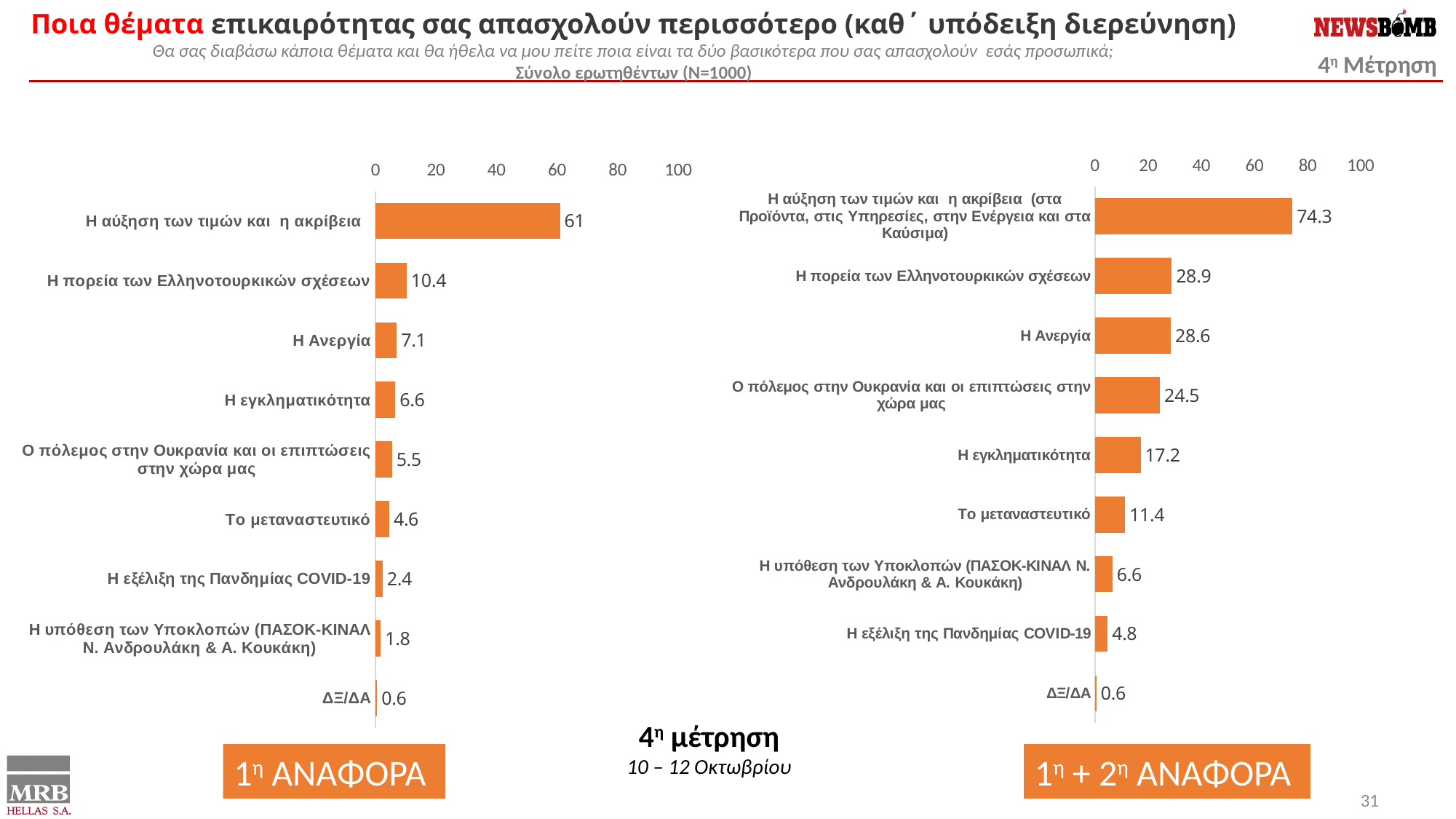
In the right chart (1η + 2η ΑΝΑΦΟΡΑ), what is the difference between 'Ο πόλεμος στην Ουκρανία και οι επιπτώσεις στην χώρα μας' and 'Η εγκληματικότητα'? 7.3 In the left chart (1η ΑΝΑΦΟΡΑ), which is larger: 'Η Ανεργία' or 'Η εγκληματικότητα'? Η Ανεργία What kind of chart is the right chart (1η + 2η ΑΝΑΦΟΡΑ)? Bar chart In the left chart (1η ΑΝΑΦΟΡΑ), what is the value for 'Η αύξηση των τιμών και η ακρίβεια'? 61 In the right chart (1η + 2η ΑΝΑΦΟΡΑ), is the value for 'Η Ανεργία' greater or less than 20? greater In the left chart (1η ΑΝΑΦΟΡΑ), which category has the lowest value? ΔΞ/ΔΑ How many categories are shown in the left chart (1η ΑΝΑΦΟΡΑ)? 9 In the left chart (1η ΑΝΑΦΟΡΑ), what is the difference between 'Η αύξηση των τιμών και η ακρίβεια' and 'Η πορεία των Ελληνοτουρκικών σχέσεων'? 50.6 In the right chart (1η + 2η ΑΝΑΦΟΡΑ), what is the value for 'Η πορεία των Ελληνοτουρκικών σχέσεων'? 28.9 In the left chart (1η ΑΝΑΦΟΡΑ), what is the value for 'Το μεταναστευτικό'? 4.6 In the right chart (1η + 2η ΑΝΑΦΟΡΑ), which category has the highest value? Η αύξηση των τιμών και η ακρίβεια (στα Προϊόντα, στις Υπηρεσίες, στην Ενέργεια και στα Καύσιμα) In the right chart (1η + 2η ΑΝΑΦΟΡΑ), what is the value for 'Η εξέλιξη της Πανδημίας COVID-19'? 4.8